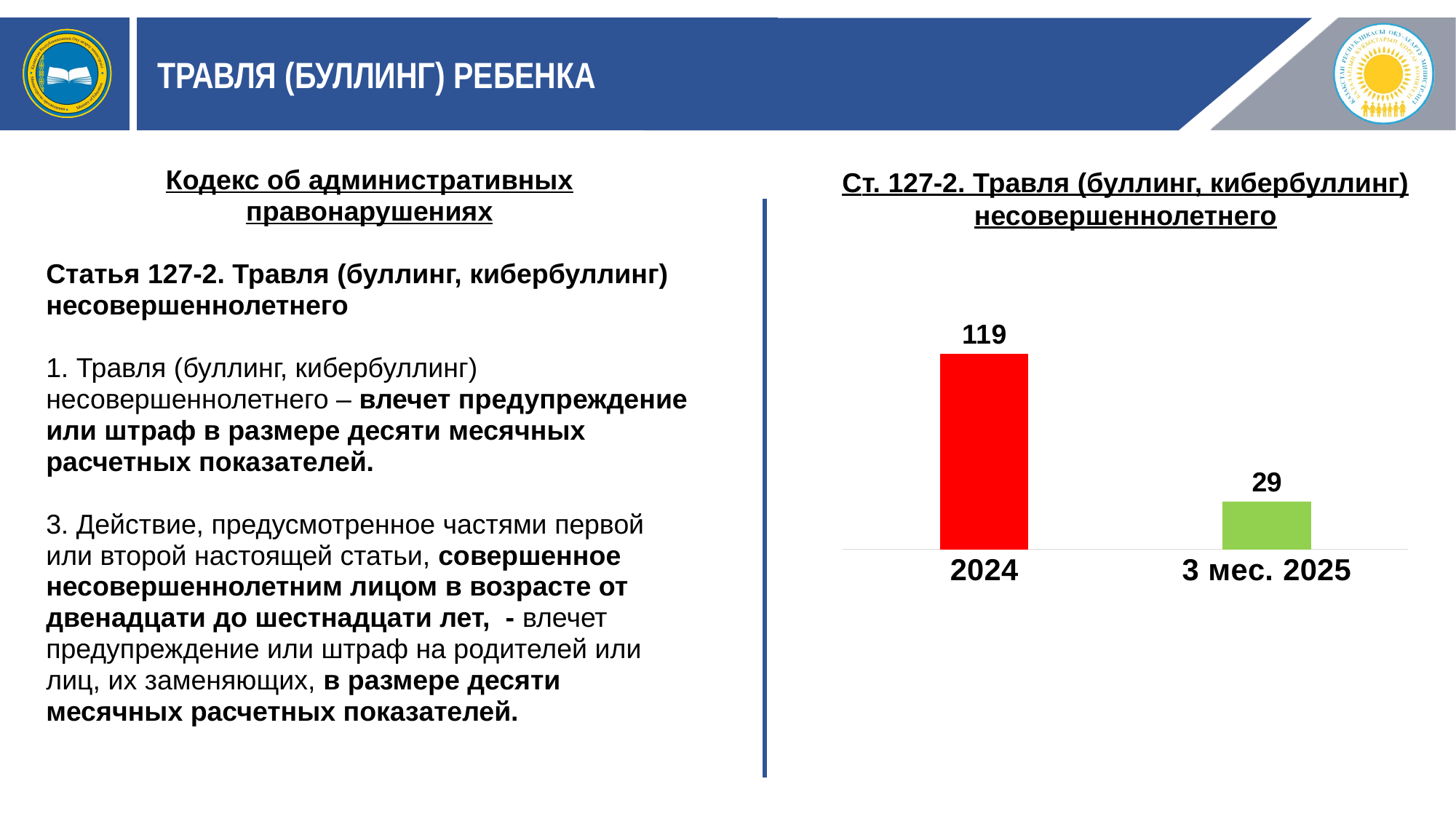
What is the value for 2024? 119 Which category has the lowest value? 3 мес. 2025 What is the value for 3 мес. 2025? 29 Do the values rise or fall from 2024 to 3 мес. 2025? Fall What is the difference between the values for 2024 and 3 мес. 2025? 90 Which is larger, the value for 2024 or the value for 3 мес. 2025? 2024 What colour is the bar for 2024? Red How many categories are shown on the chart? 2 What kind of chart is shown on the slide? Bar chart Which category has the highest value? 2024 What is the title of the chart? Ст. 127-2. Травля (буллинг, кибербуллинг) несовершеннолетнего